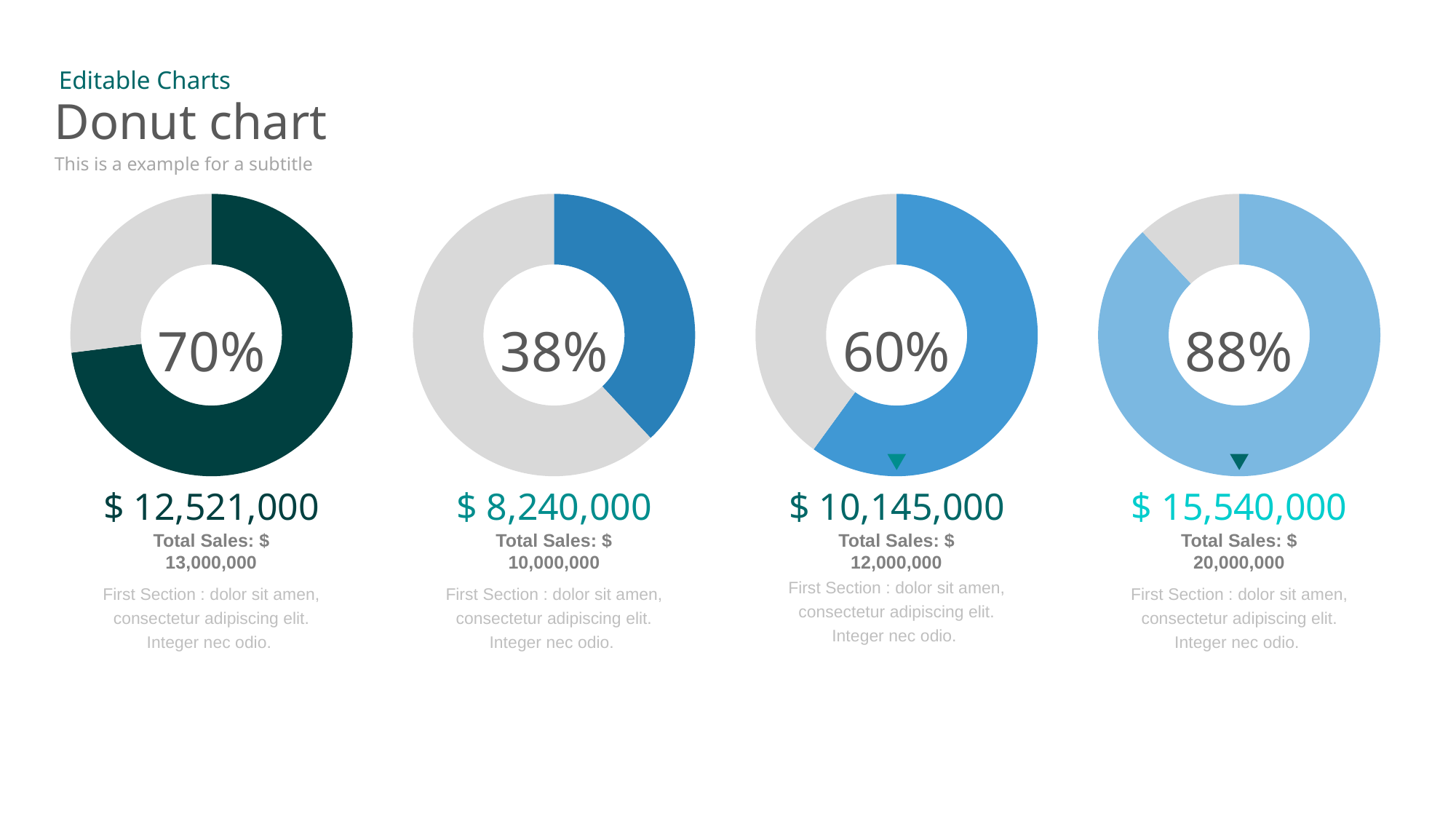
Which shows a larger percentage, the leftmost donut chart or the third donut chart from the left? The leftmost (70%) What dollar value is printed below the leftmost donut chart? $ 12,521,000 What is the Total Sales figure printed below the rightmost donut chart? $ 20,000,000 In the rightmost donut chart, what percentage is shown in the centre? 88% What is the difference in percentage points between the rightmost donut chart and the second donut chart from the left? 50 percentage points In the leftmost donut chart, what percentage is shown in the centre? 70% Which donut chart shows the highest percentage? The rightmost one (88%) How many donut charts are shown on the slide? 4 In the third donut chart from the left, what percentage is shown in the centre? 60% Which donut chart shows the lowest percentage? The second from the left (38%) What kind of chart is used on this slide? Donut chart In the second donut chart from the left, what percentage is shown in the centre? 38%